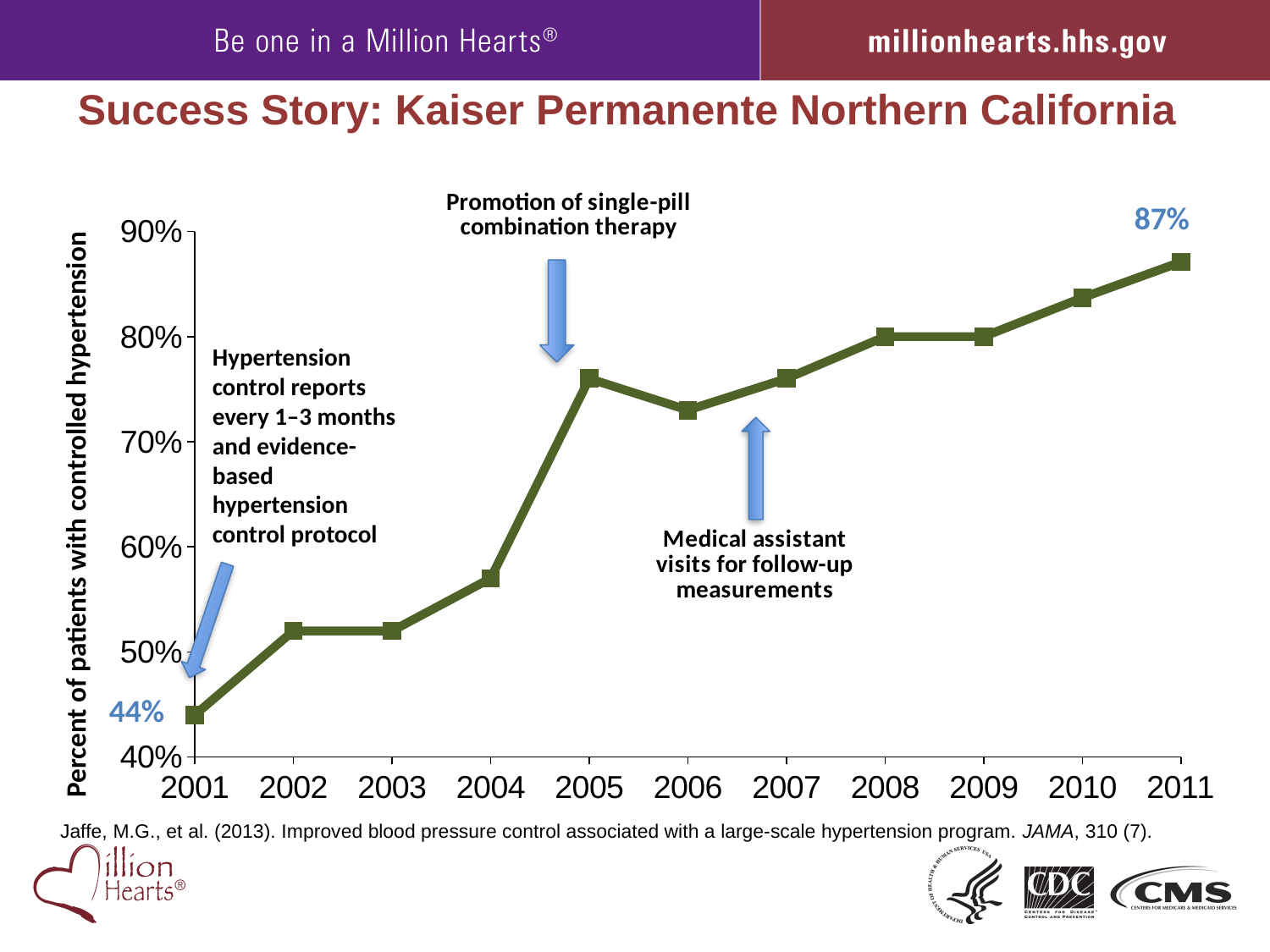
Which year has a higher percent of patients with controlled hypertension, 2005 or 2006? 2005 What is the percent of patients with controlled hypertension in 2011? 87% What kind of chart is shown on the slide? Line chart Overall, do the values rise or fall from 2001 to 2011? Rise Is the value for 2004 greater or less than 60%? less Is the value for 2007 greater or less than 70%? greater By how many percentage points did the percent of patients with controlled hypertension increase from 2001 to 2011? 43 percentage points Which year has the highest percent of patients with controlled hypertension? 2011 Which year has the lowest percent of patients with controlled hypertension? 2001 Is the value for 2002 greater or less than 60%? less What is the percent of patients with controlled hypertension in 2001? 44% How many years are plotted on the x axis? 11